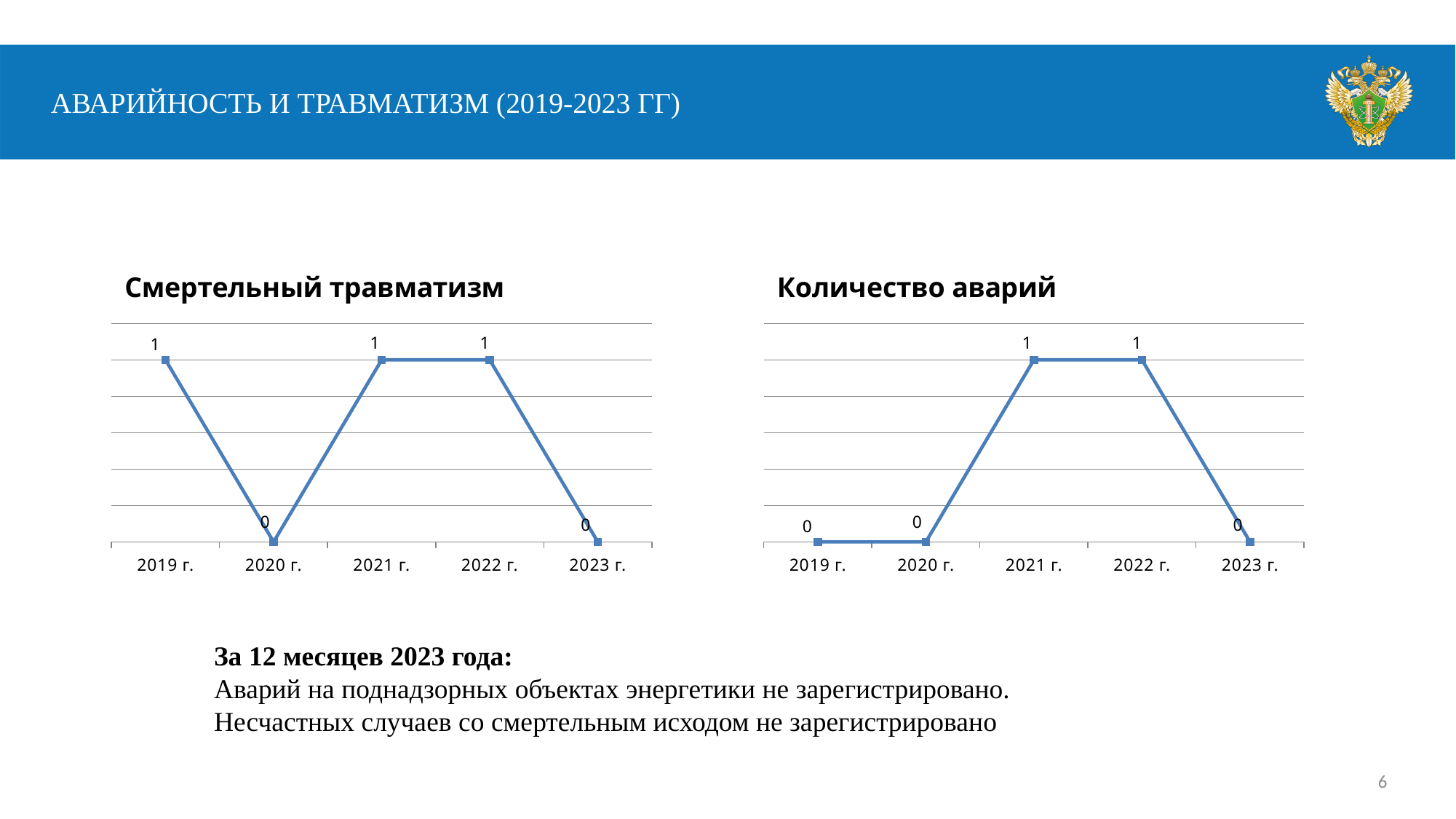
In the "Смертельный травматизм" chart, does the value rise or fall from 2020 г. to 2021 г.? rise In the "Количество аварий" chart, which is larger, the value for 2021 г. or the value for 2023 г.? 2021 г. In the "Количество аварий" chart, what is the value for 2019 г.? 0 In the "Смертельный травматизм" chart, what is the value for 2019 г.? 1 In the "Количество аварий" chart, what is the value for 2023 г.? 0 In the "Количество аварий" chart, what is the value for 2022 г.? 1 In the "Количество аварий" chart, does the value rise or fall from 2022 г. to 2023 г.? fall In the "Смертельный травматизм" chart, what is the value for 2020 г.? 0 What is the title of the chart on the right side of the slide? Количество аварий What kind of chart is the "Количество аварий" chart? line chart In the "Смертельный травматизм" chart, what is the difference between the values for 2019 г. and 2020 г.? 1 How many years are plotted on the x axis of the "Смертельный травматизм" chart? 5